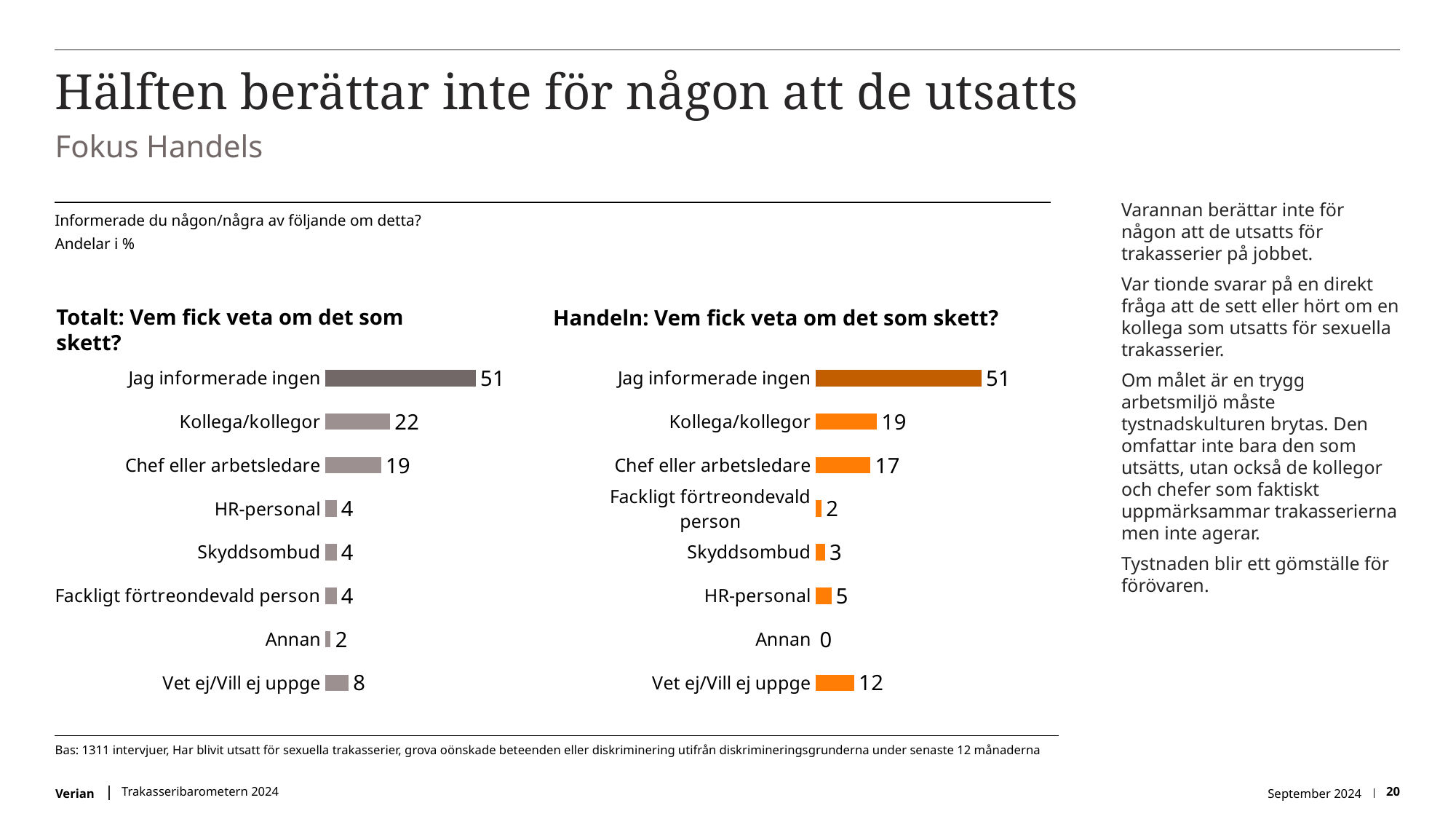
What type of chart is 'Totalt: Vem fick veta om det som skett?'? Bar chart What colour are the bars in the chart 'Handeln: Vem fick veta om det som skett?'? Orange In the chart 'Handeln: Vem fick veta om det som skett?', what is the difference between Jag informerade ingen and Kollega/kollegor? 32 In the chart 'Totalt: Vem fick veta om det som skett?', which category has the highest value? Jag informerade ingen Which is larger: HR-personal in the 'Totalt' chart or HR-personal in the 'Handeln' chart? Handeln In the chart 'Totalt: Vem fick veta om det som skett?', which category has the lowest value? Annan In the chart 'Totalt: Vem fick veta om det som skett?', what is the value for Kollega/kollegor? 22 How many categories are shown in the chart 'Handeln: Vem fick veta om det som skett?'? 8 In the chart 'Handeln: Vem fick veta om det som skett?', what is the value for Chef eller arbetsledare? 17 In the chart 'Handeln: Vem fick veta om det som skett?', which category has the lowest value? Annan In the chart 'Handeln: Vem fick veta om det som skett?', what is the value for Vet ej/Vill ej uppge? 12 In the chart 'Totalt: Vem fick veta om det som skett?', what is the difference between Kollega/kollegor and Chef eller arbetsledare? 3